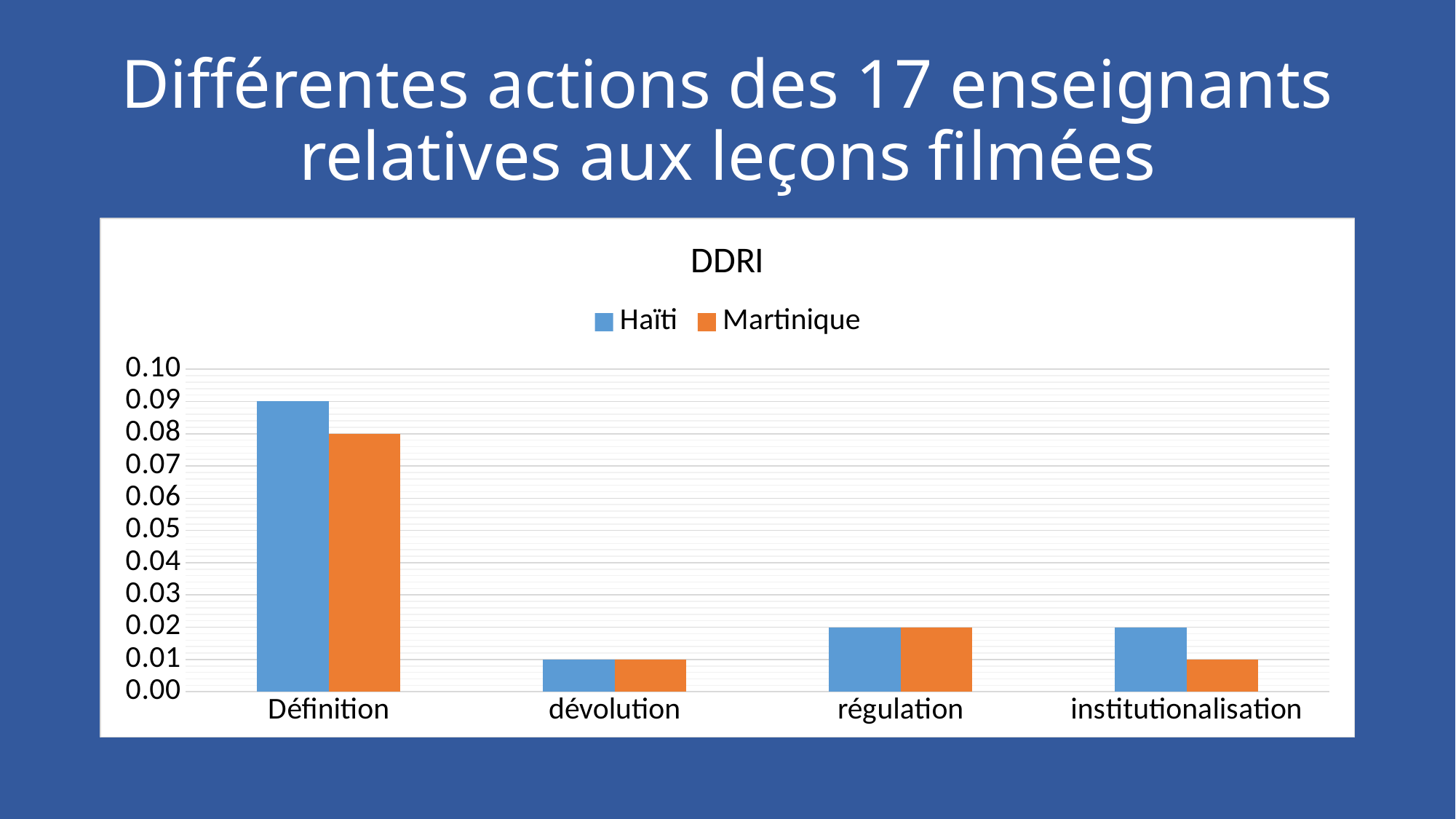
What is the value for Haïti in the Définition category? 0.09 Which category has the highest value for Haïti? Définition What type of chart is shown on the slide? bar chart What is the value for Martinique in the institutionalisation category? 0.01 How many categories are shown on the x axis? 4 What is the value for Martinique in the Définition category? 0.08 What is the difference between the Haïti and Martinique values for Définition? 0.01 Is the value for Haïti in the Définition category greater or less than 0.05? greater Which category has the lowest value for Haïti? dévolution In the institutionalisation category, which series has the larger value, Haïti or Martinique? Haïti How many series does the legend list? 2 What is the title of the chart? DDRI